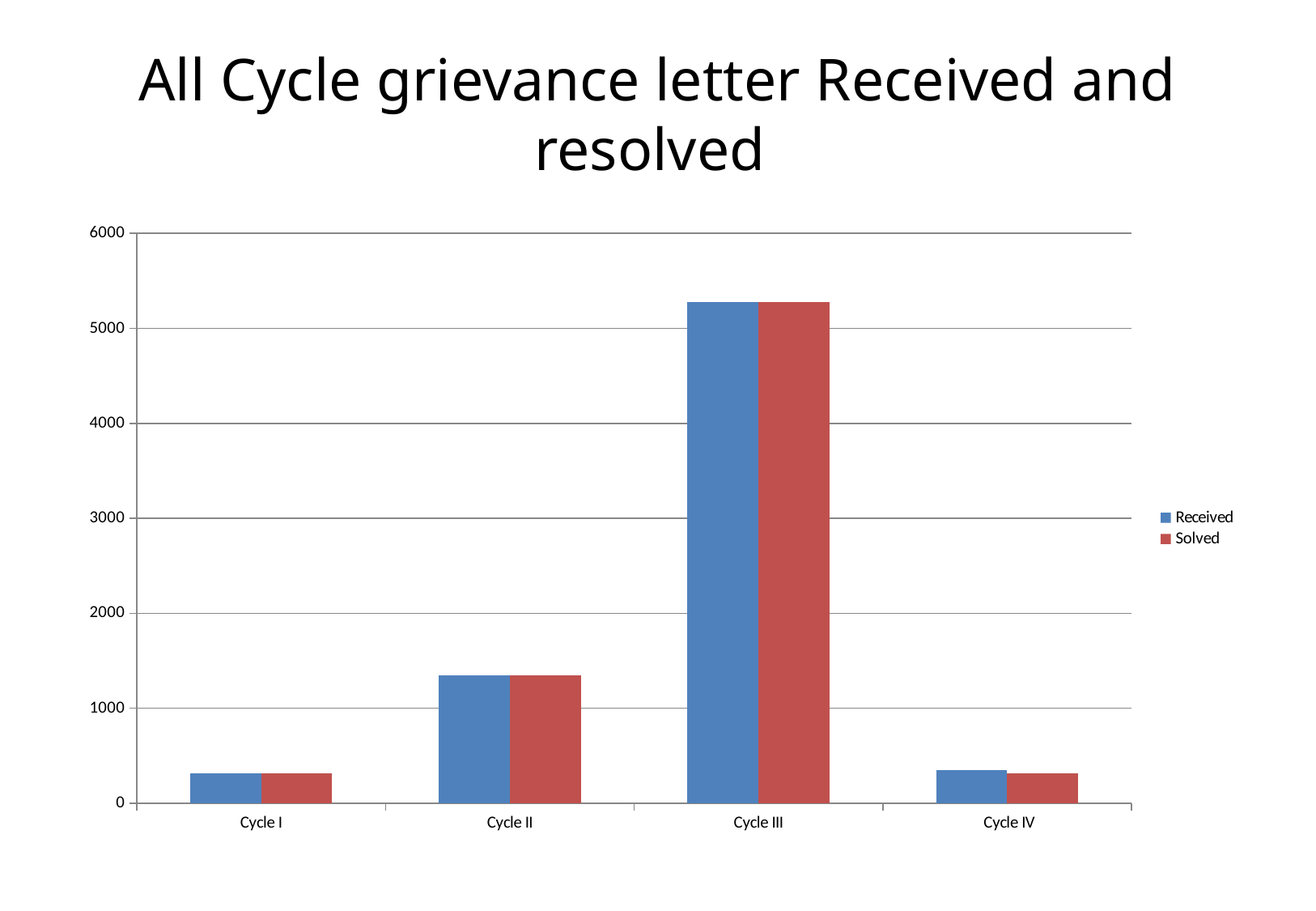
Which cycle has the highest Received value? Cycle III Which colour represents the Solved series in the legend? red What kind of chart is shown on the slide? bar chart Is the Received value for Cycle III greater or less than 5000? greater Is the Solved value for Cycle IV greater or less than 1000? less Is the Solved value for Cycle I greater or less than 1000? less Which is larger, the Received value for Cycle II or the Received value for Cycle IV? Cycle II How many cycles are shown on the x axis? 4 What is the title of the chart? All Cycle grievance letter Received and resolved Which cycle has the highest Solved value? Cycle III How many series does the legend list? 2